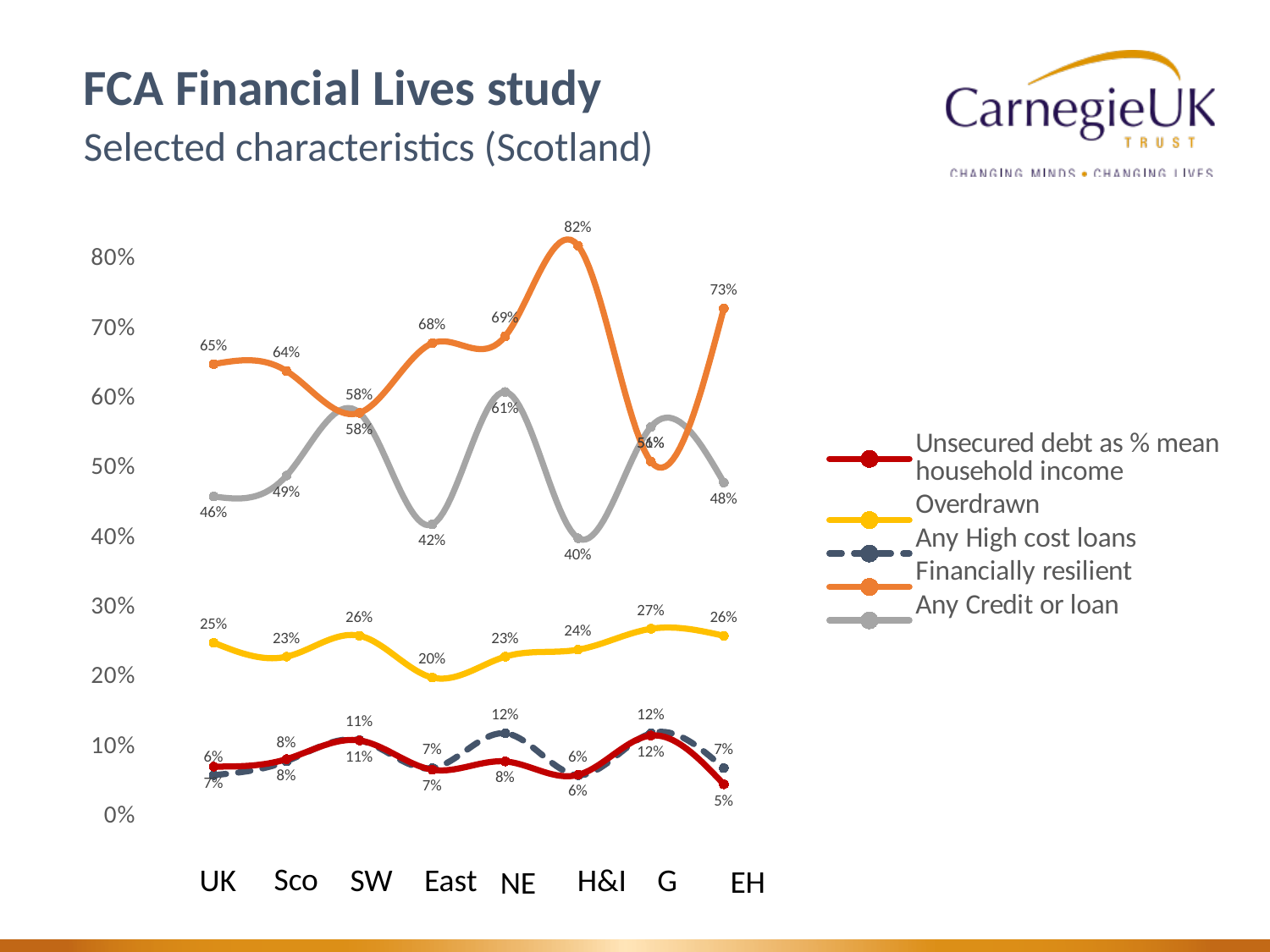
What is the Any Credit or loan value for NE? 61% How many series does the legend list? 5 What kind of chart is shown on the slide? line chart Which category has the highest Financially resilient value? H&I What is the Unsecured debt as % mean household income value for EH? 5% How many categories are shown along the x axis? 8 Which is larger for Any Credit or loan: SW or East? SW Which category has the highest Overdrawn value? G What is the difference between the Financially resilient values for EH and UK? 8 percentage points What is the Financially resilient value for H&I? 82% Which category has the lowest Overdrawn value? East What is the Overdrawn value for East? 20%